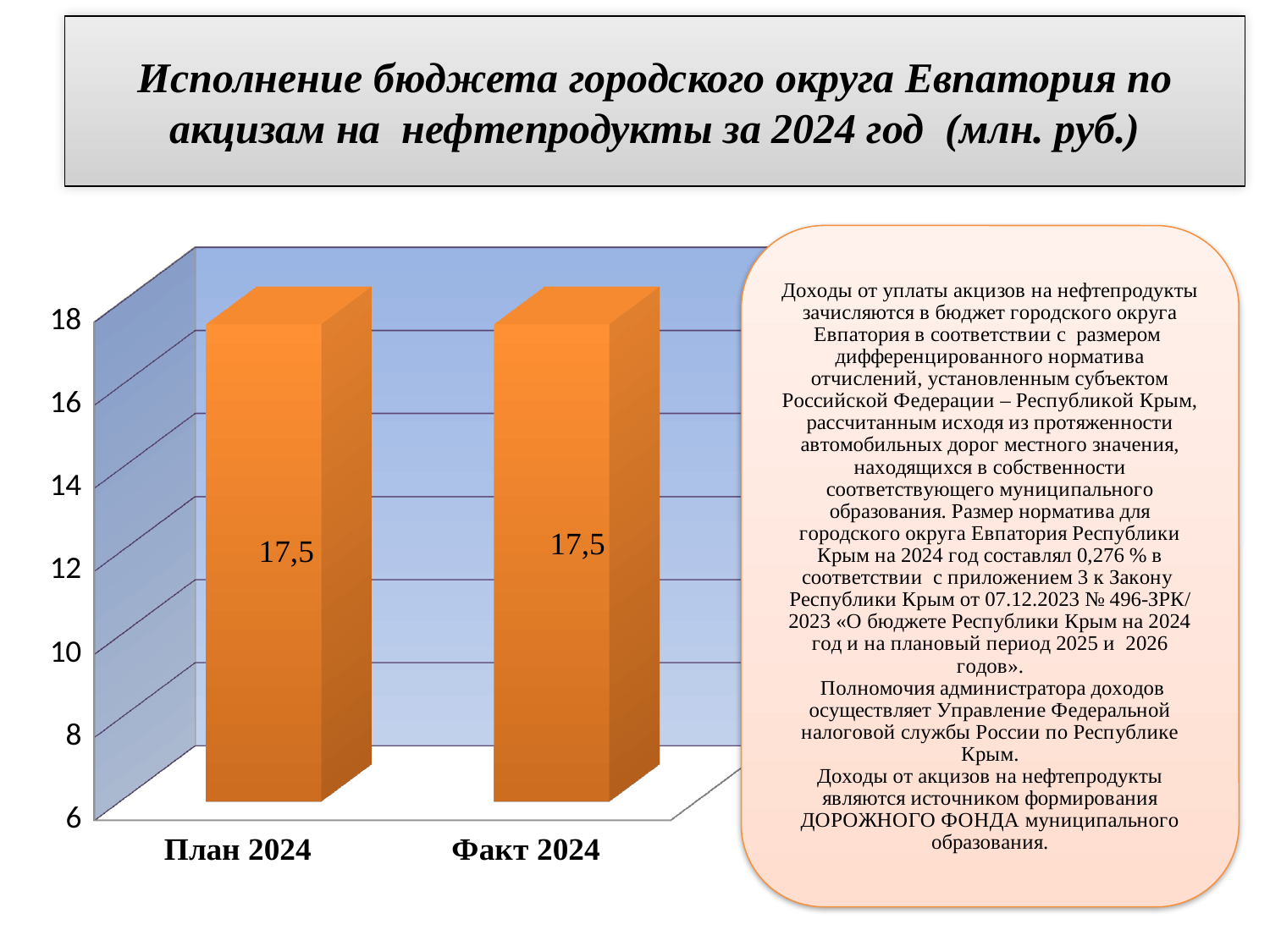
What kind of chart is shown on the slide? bar chart Is the value for Факт 2024 greater or less than 18? less Do the values rise, fall, or stay the same from План 2024 to Факт 2024? stay the same What is the value for План 2024? 17,5 What is the value for Факт 2024? 17,5 How many categories are shown on the chart? 2 What is the difference between the values for План 2024 and Факт 2024? 0 Is the value for Факт 2024 larger than, smaller than, or equal to the value for План 2024? equal Is the value for План 2024 greater or less than 16? greater In what units are the values on the chart expressed, according to the slide title? млн. руб. What are the category labels on the x axis of the chart? План 2024, Факт 2024